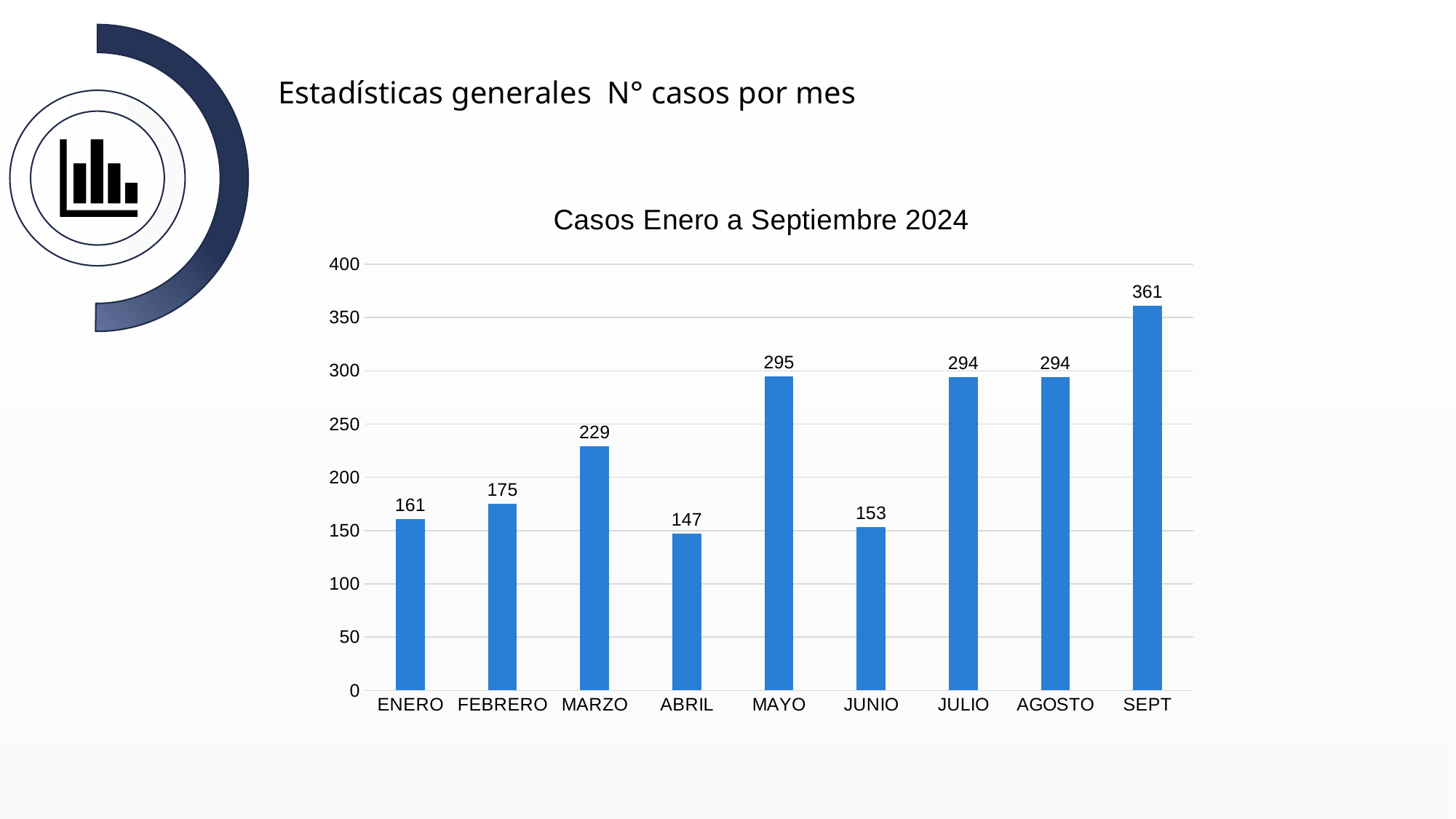
What is the title of the chart? Casos Enero a Septiembre 2024 What kind of chart is shown on the slide? Bar chart What is the value for MAYO? 295 Which month has the highest number of cases? SEPT What is the value for ENERO? 161 Is the value for MARZO greater or less than 200? greater What is the difference between the values for SEPT and MAYO? 66 What is the difference between the values for MARZO and FEBRERO? 54 What is the value for ABRIL? 147 Which is larger, the value for JUNIO or the value for FEBRERO? FEBRERO How many months are shown on the x axis? 9 Which month has the lowest number of cases? ABRIL